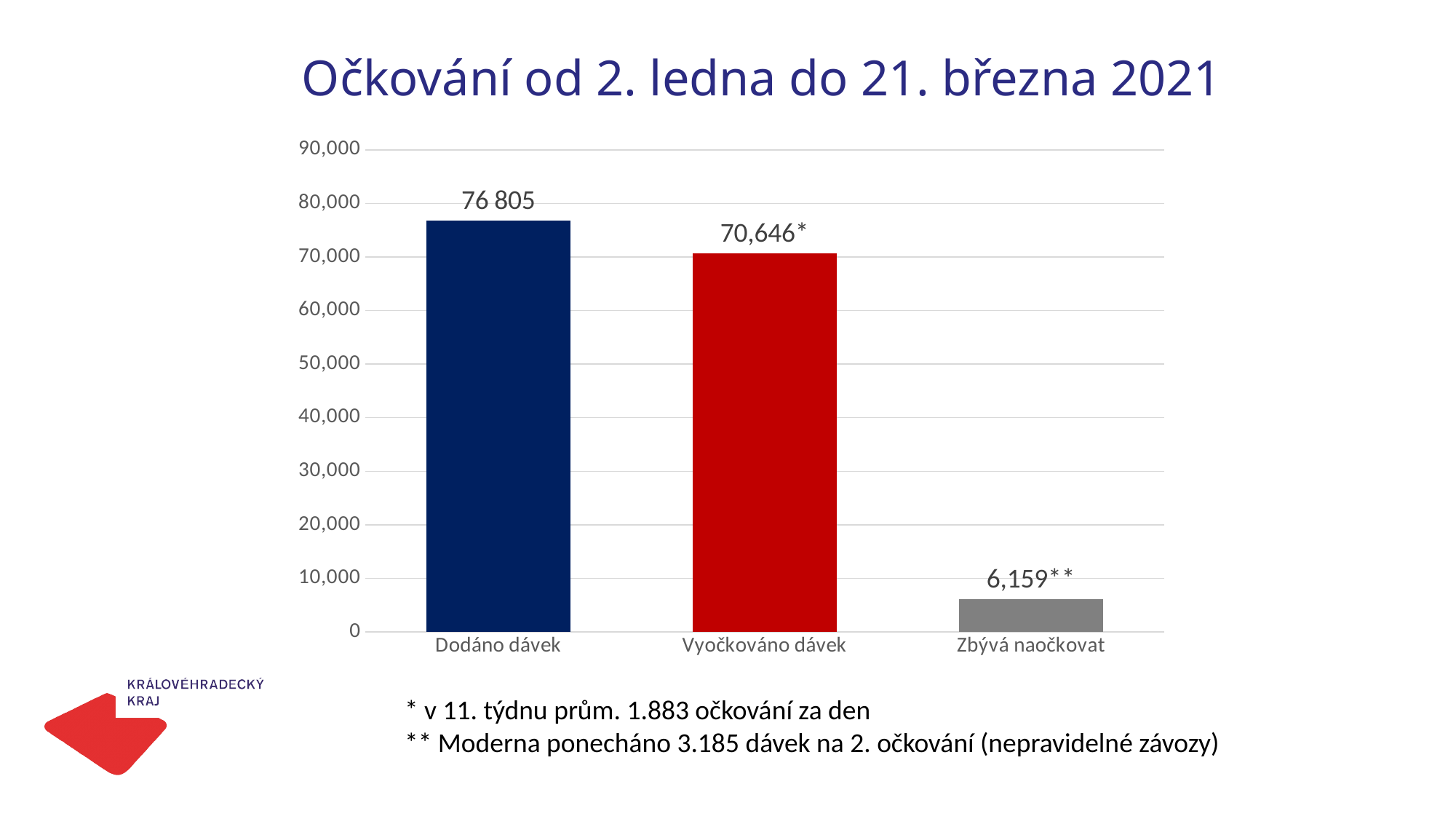
Which category has the lowest value? Zbývá naočkovat What is the difference between Vyočkováno dávek and Zbývá naočkovat? 64,487 How many categories are shown in the chart? 3 What kind of chart is shown on the slide? bar chart What is the title of the chart? Očkování od 2. ledna do 21. března 2021 Is the value for Zbývá naočkovat greater or less than 10,000? less Which category has the highest value? Dodáno dávek What is the value for Vyočkováno dávek? 70,646 Which is larger, Dodáno dávek or Vyočkováno dávek? Dodáno dávek What is the value for Dodáno dávek? 76 805 What is the value for Zbývá naočkovat? 6,159 What is the difference between Dodáno dávek and Vyočkováno dávek? 6,159